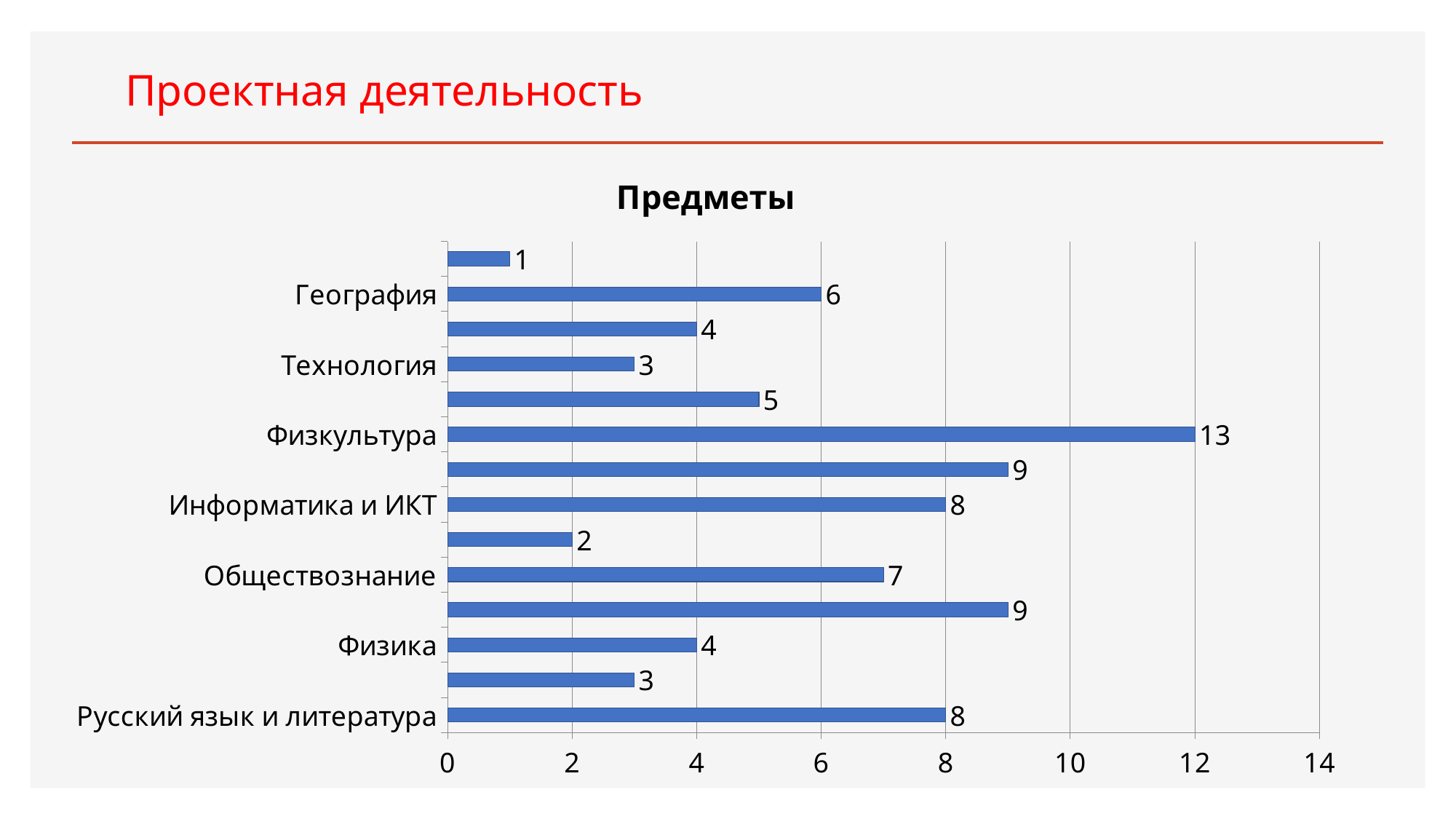
What is the value for География? 6 What is the value for Физкультура? 13 What type of chart is shown on the slide? bar chart Which is larger, the value for Обществознание or the value for Русский язык и литература? Русский язык и литература What is the difference between the values for Физкультура and Физика? 9 What is the value for Информатика и ИКТ? 8 What is the value for Обществознание? 7 What is the title of the chart? Предметы What is the value for Технология? 3 Which labeled category has the highest value? Физкультура How many bars are plotted in the chart? 14